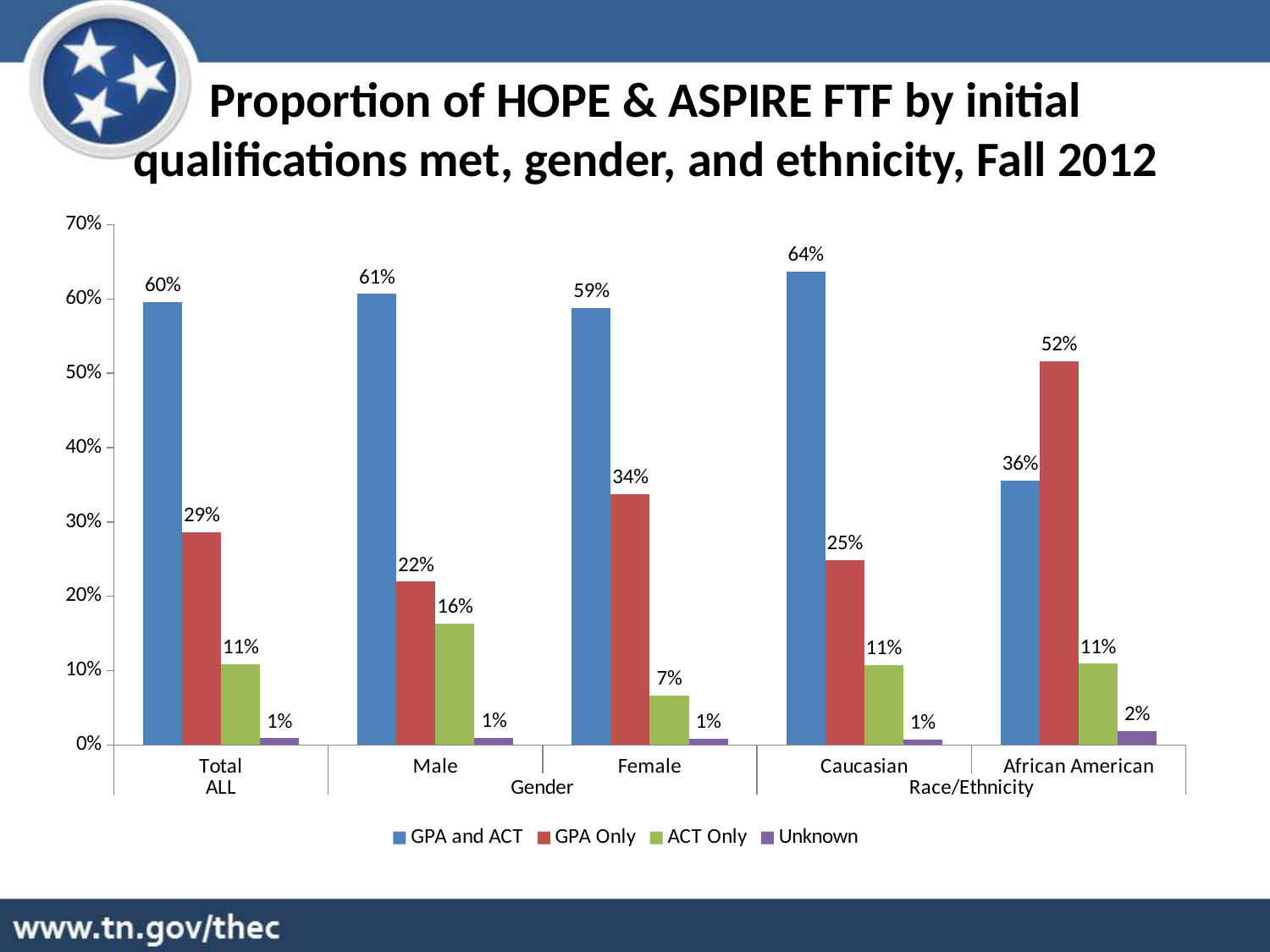
Which category has the highest value for GPA and ACT? Caucasian What is the difference between the GPA Only values for Female and Male? 12% What is the value for ACT Only in the Male category? 16% What is the value for GPA Only in the African American category? 52% What colour represents the GPA Only series? Red How many categories are shown on the x axis? 5 Which is larger in the African American category, GPA and ACT or GPA Only? GPA Only Which category has the lowest value for ACT Only? Female What kind of chart is shown on the slide? Bar chart How many series does the legend list? 4 What is the value for GPA and ACT in the Caucasian category? 64% What is the value for Unknown in the African American category? 2%